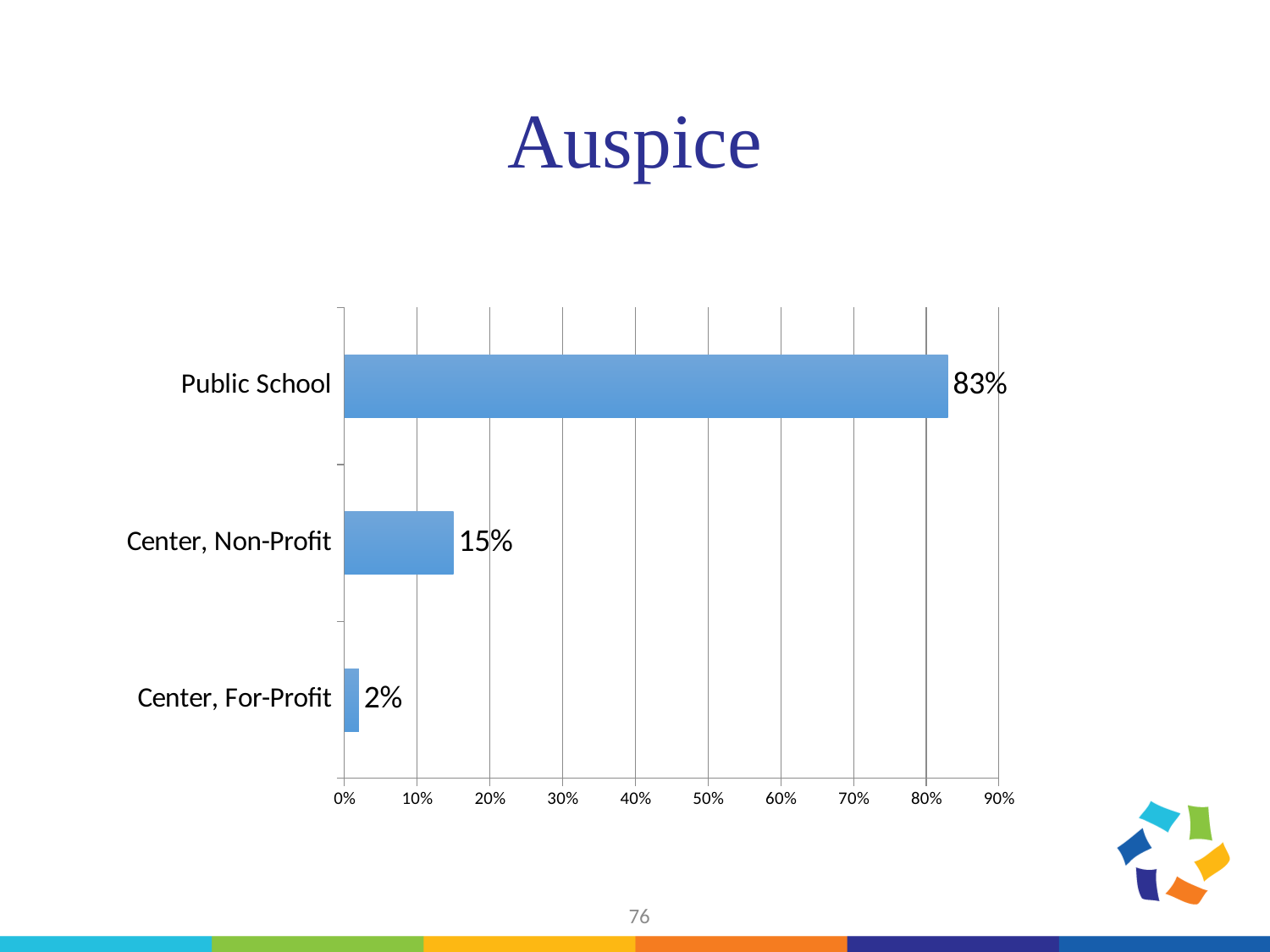
What is the value for Public School? 83% What is the value for Center, Non-Profit? 15% Which category has the lowest value? Center, For-Profit Which is larger, the value for Center, Non-Profit or the value for Center, For-Profit? Center, Non-Profit What is the difference between the values for Center, Non-Profit and Center, For-Profit? 13% Is the value for Public School greater or less than 80%? greater What is the value for Center, For-Profit? 2% What is the title of the slide? Auspice What is the difference between the values for Public School and Center, Non-Profit? 68% Which category has the highest value? Public School What kind of chart is shown on the slide? bar chart How many categories are shown in the chart? 3